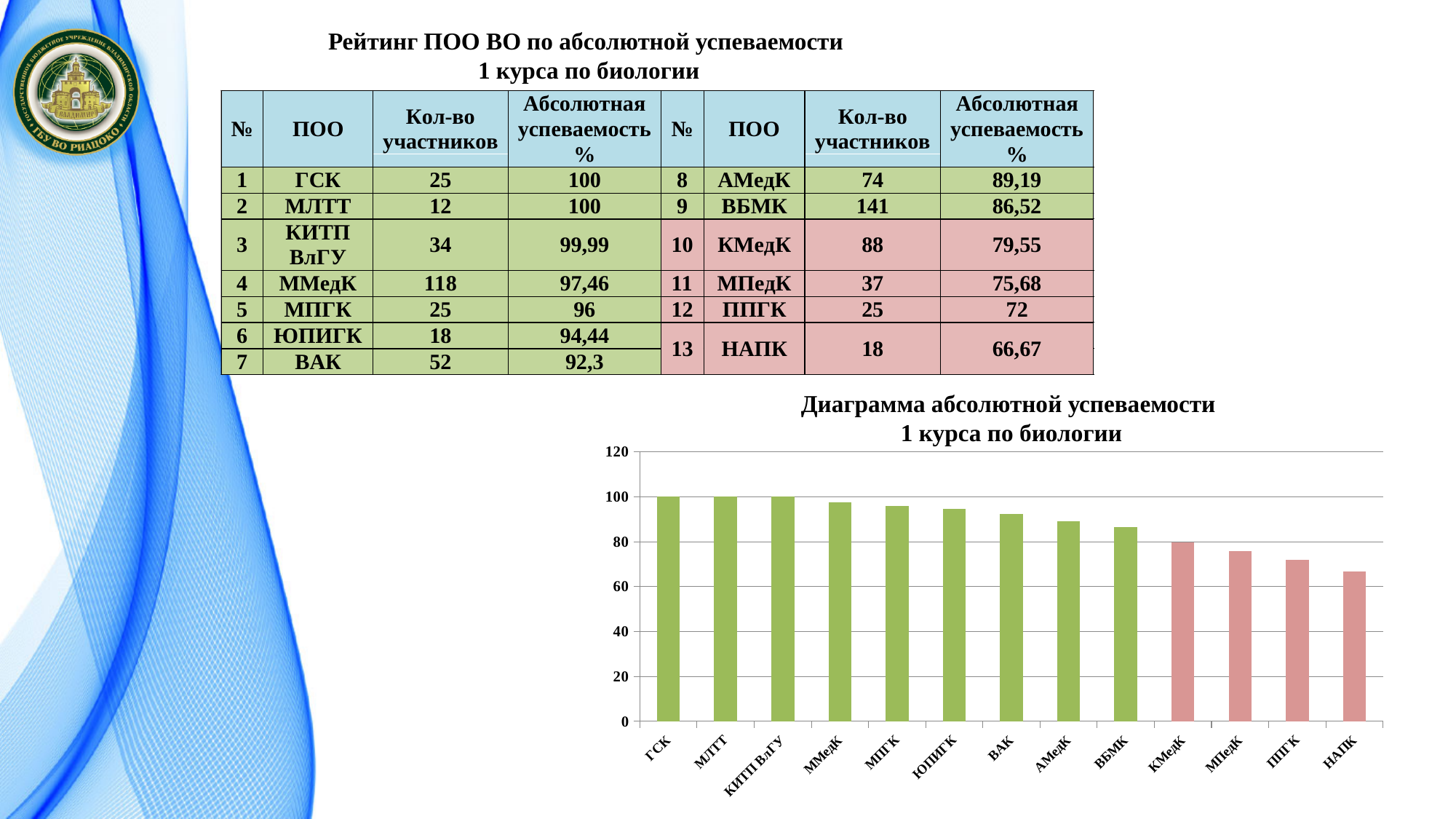
Is the value for ВАК greater or less than 100? less Which bar is taller, ППГК or НАПК? ППГК Is the value for МПедК greater or less than 80? less Is the value for НАПК greater or less than 60? greater Which bar is taller, ВАК or АМедК? ВАК Which institution has the lowest bar in the chart? НАПК Do the bar values rise or fall from left to right along the x axis? fall What is the value of the bar for ГСК? 100 What kind of chart is shown on the slide? bar chart How many institutions (bars) are plotted in the chart? 13 How many bars in the chart are coloured pink rather than green? 4